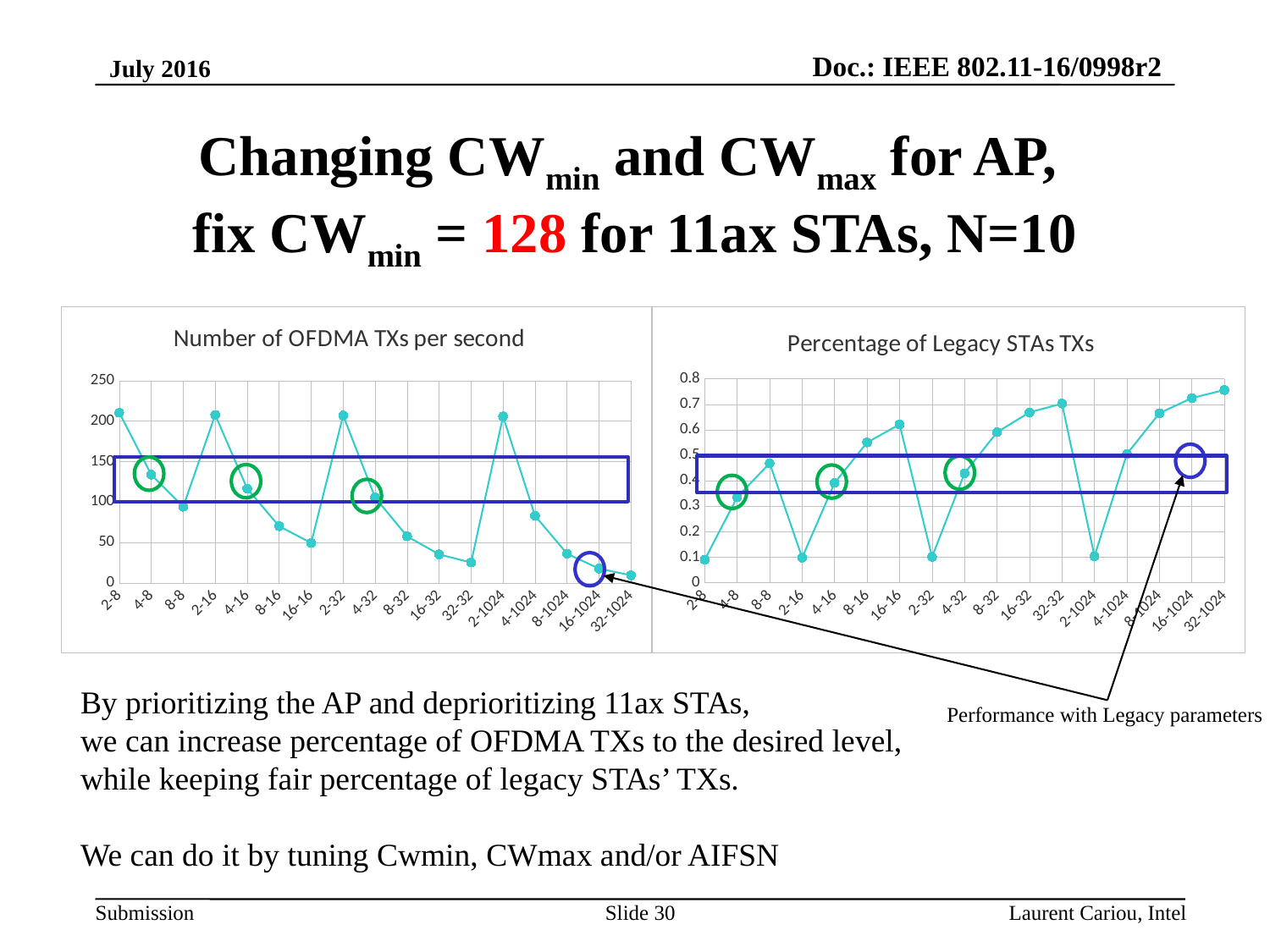
What is the title of the chart on the left side of the slide? Number of OFDMA TXs per second In the 'Number of OFDMA TXs per second' chart, is the value for 2-8 greater or less than 200? greater In the 'Number of OFDMA TXs per second' chart, which is larger, the value for 2-8 or the value for 8-8? 2-8 In the 'Percentage of Legacy STAs TXs' chart, which is larger, the value for 8-16 or the value for 2-16? 8-16 In the 'Number of OFDMA TXs per second' chart, is the value for 8-8 greater or less than 100? less In the 'Number of OFDMA TXs per second' chart, do the values rise or fall from 2-1024 to 32-1024? fall What is the title of the chart on the right side of the slide? Percentage of Legacy STAs TXs What type of chart is the 'Number of OFDMA TXs per second' chart? line chart In the 'Percentage of Legacy STAs TXs' chart, is the value for 4-8 greater or less than 0.4? less How many categories are shown on the x axis of the 'Percentage of Legacy STAs TXs' chart? 17 In the 'Number of OFDMA TXs per second' chart, which category has the lowest value? 32-1024